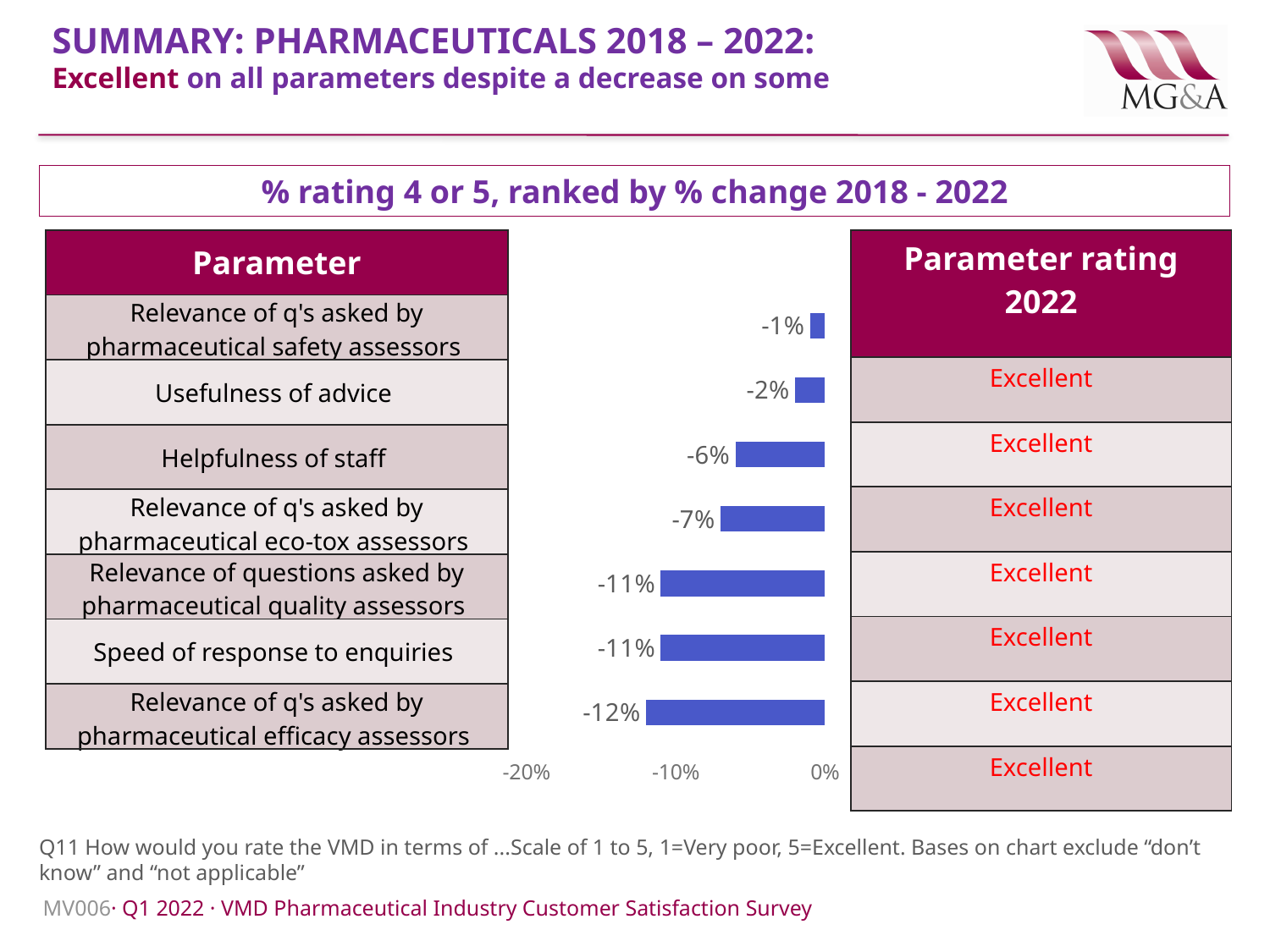
Which has a larger decrease: Usefulness of advice or Helpfulness of staff? Helpfulness of staff What is the title of the chart? % rating 4 or 5, ranked by % change 2018 - 2022 What is the % change 2018 - 2022 for Relevance of q's asked by pharmaceutical efficacy assessors? -12% What is the lowest value shown on the chart's horizontal axis? -20% What is the % change 2018 - 2022 for Usefulness of advice? -2% What is the % change 2018 - 2022 for Speed of response to enquiries? -11% What is the % change 2018 - 2022 for Helpfulness of staff? -6% What is the difference between the % change for Helpfulness of staff and the % change for Relevance of q's asked by pharmaceutical eco-tox assessors? 1 percentage point What type of chart is shown on the slide? Bar chart Which parameter shows the smallest decrease from 2018 to 2022? Relevance of q's asked by pharmaceutical safety assessors How many parameters are plotted in the bar chart? 7 Which parameter shows the largest decrease from 2018 to 2022? Relevance of q's asked by pharmaceutical efficacy assessors